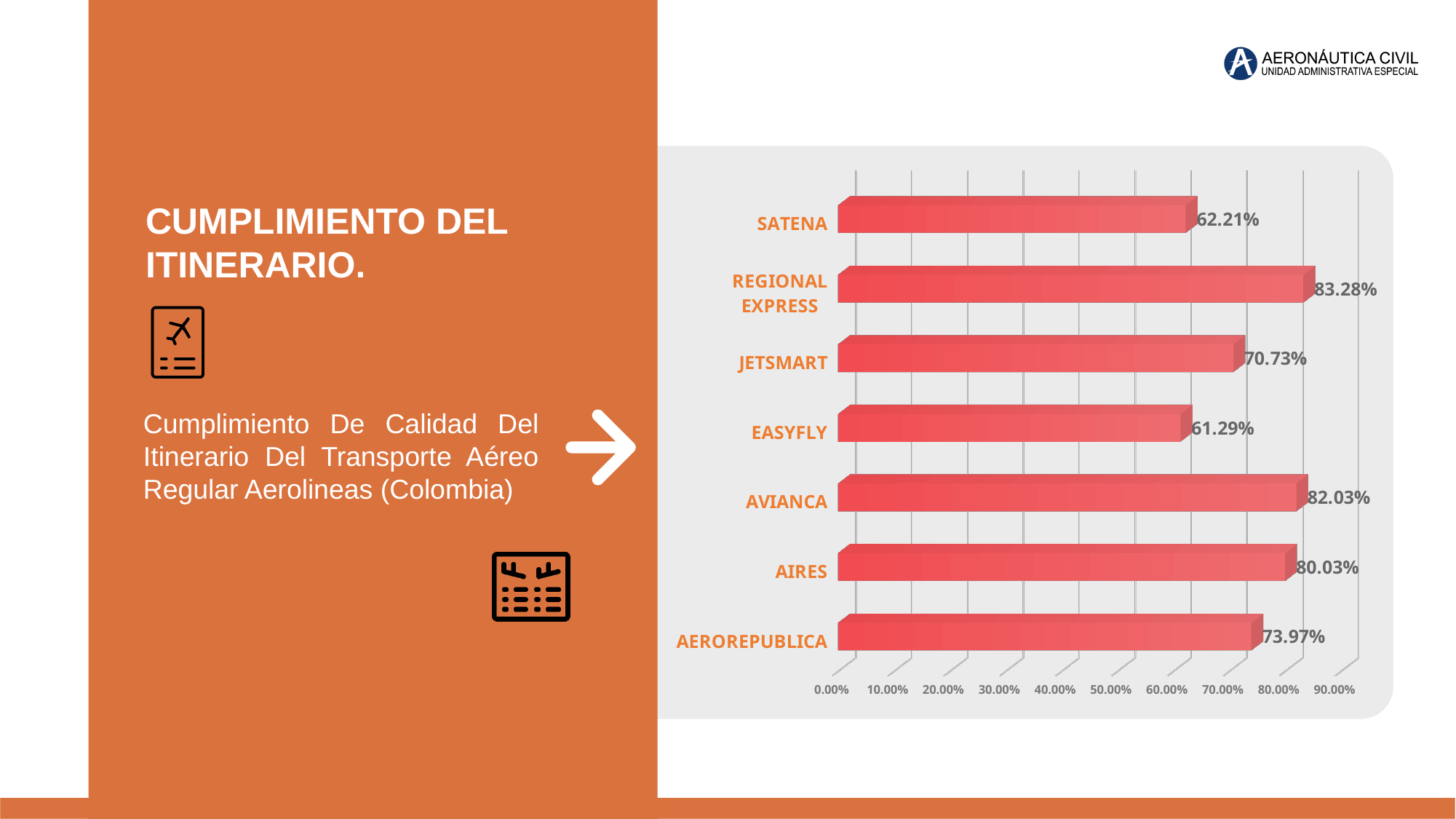
What is the value for EASYFLY? 61.29% Which airline has the lowest value? EASYFLY Which airline has the highest value? REGIONAL EXPRESS What is the difference between the values for AVIANCA and AIRES? 2.00% Which is larger, the value for JETSMART or the value for AEROREPUBLICA? AEROREPUBLICA What is the value for AEROREPUBLICA? 73.97% What is the value for SATENA? 62.21% What is the highest value shown on the x axis? 90.00% Is the value for AIRES greater or less than 70.00%? greater How many airlines are shown in the chart? 7 What is the value for REGIONAL EXPRESS? 83.28% What kind of chart is shown on the slide? bar chart